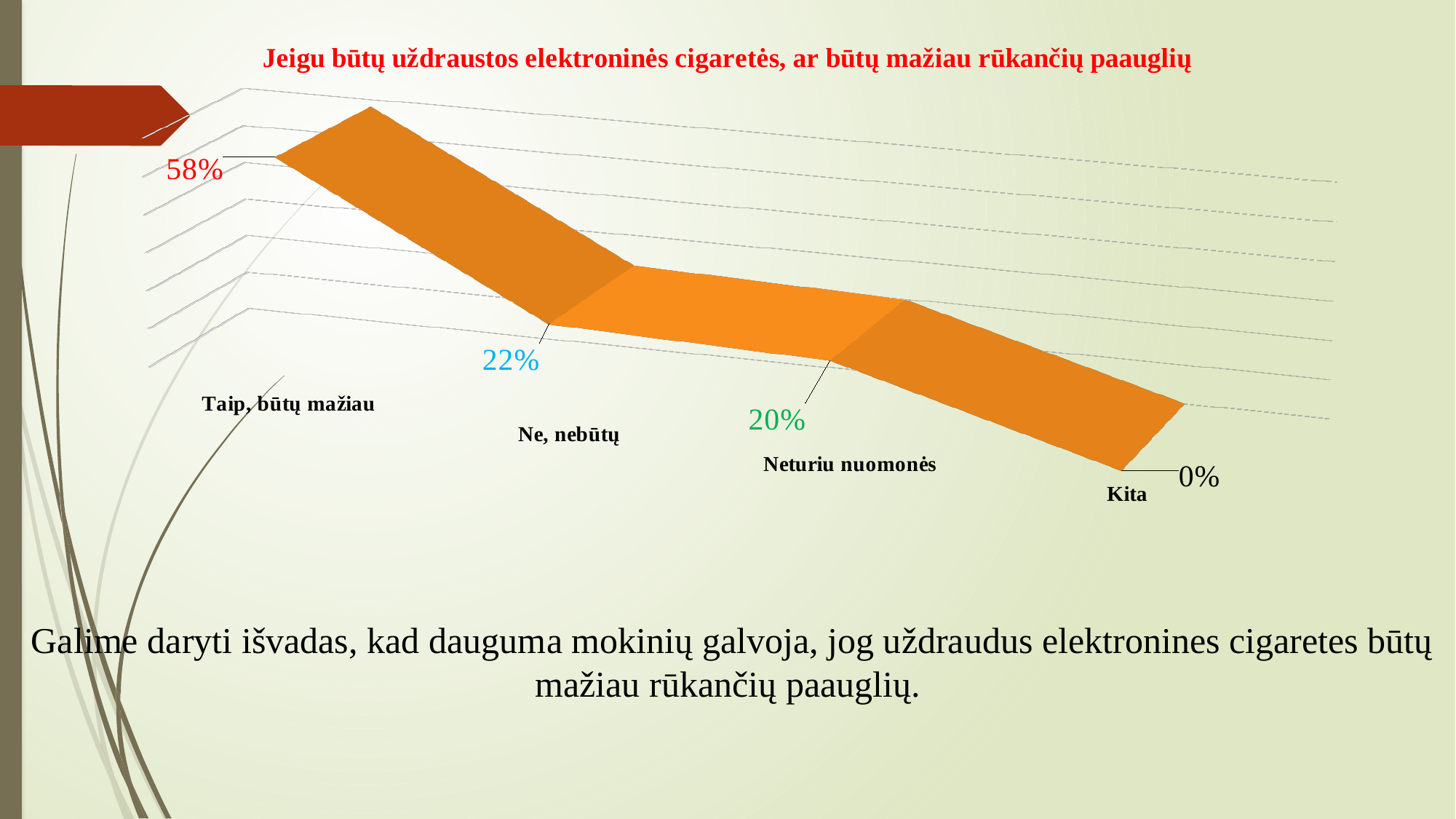
What is the title of the chart? Jeigu būtų uždraustos elektroninės cigaretės, ar būtų mažiau rūkančių paauglių What is the difference between the values for "Taip, būtų mažiau" and "Ne, nebūtų"? 36% Do the values rise or fall from left to right across the categories? fall How many categories are shown in the chart? 4 What is the value for "Ne, nebūtų"? 22% What is the value for "Taip, būtų mažiau"? 58% Which category has the highest value? Taip, būtų mažiau Which category has the lowest value? Kita Which is larger, the value for "Taip, būtų mažiau" or the value for "Neturiu nuomonės"? Taip, būtų mažiau What is the difference between the values for "Ne, nebūtų" and "Neturiu nuomonės"? 2% What is the value for "Kita"? 0% What is the value for "Neturiu nuomonės"? 20%